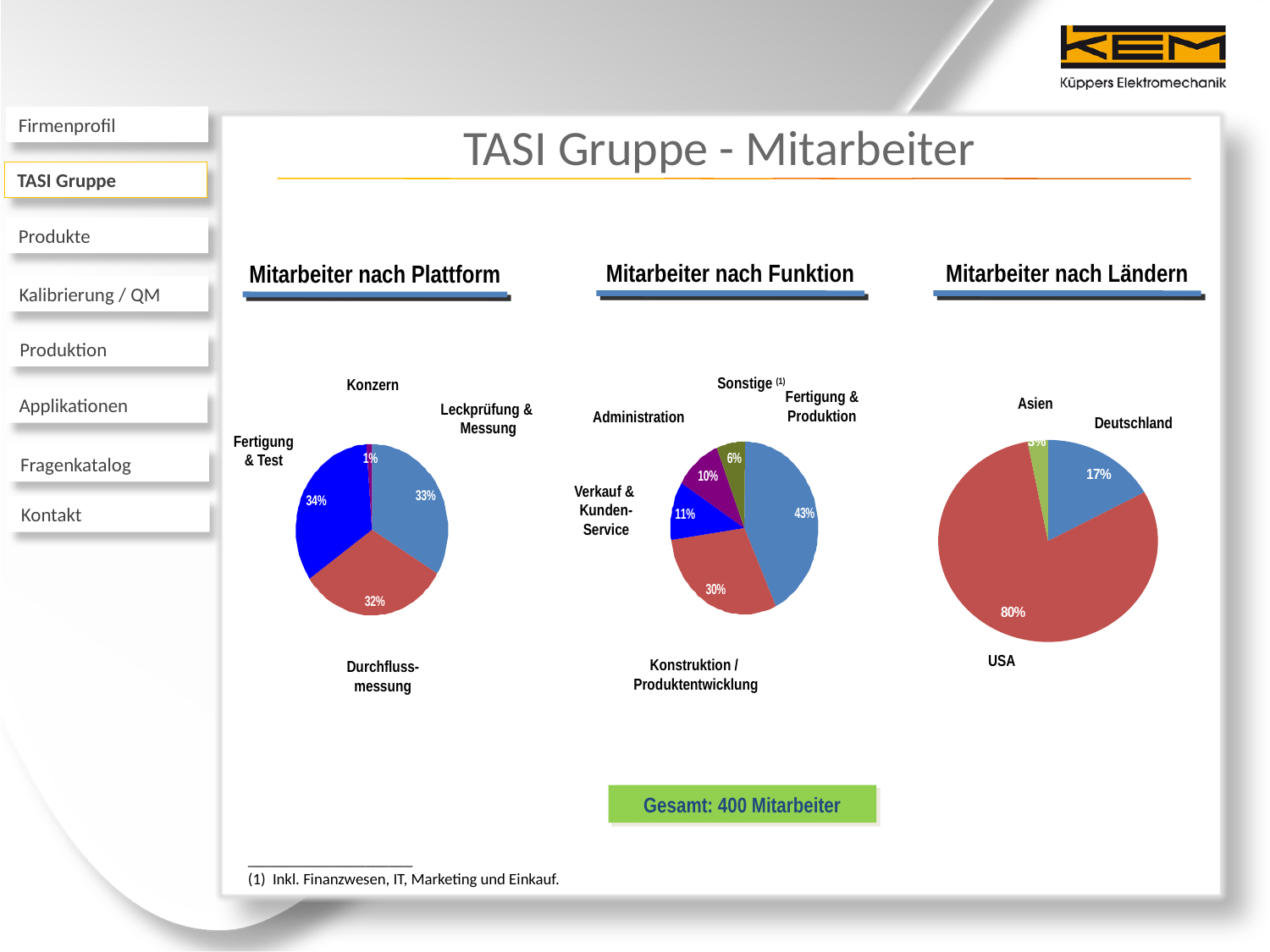
In the "Mitarbeiter nach Plattform" chart, what share is Leckprüfung & Messung? 33% In the "Mitarbeiter nach Funktion" chart, how many categories are shown? 5 In the "Mitarbeiter nach Plattform" chart, how many slices are there? 4 What total number of employees is stated below the charts? 400 Mitarbeiter What kind of chart is used for "Mitarbeiter nach Plattform"? Pie chart In the "Mitarbeiter nach Ländern" chart, which country has the smallest share? Asien In the "Mitarbeiter nach Funktion" chart, which is larger: Verkauf & Kunden-Service or Administration? Verkauf & Kunden-Service In the "Mitarbeiter nach Funktion" chart, what is the difference between Fertigung & Produktion and Konstruktion / Produktentwicklung? 13% In the "Mitarbeiter nach Funktion" chart, which category has the largest share? Fertigung & Produktion In the "Mitarbeiter nach Plattform" chart, which category has the smallest share? Konzern In the "Mitarbeiter nach Funktion" chart, what share is Fertigung & Produktion? 43% In the "Mitarbeiter nach Ländern" chart, what share is USA? 80%